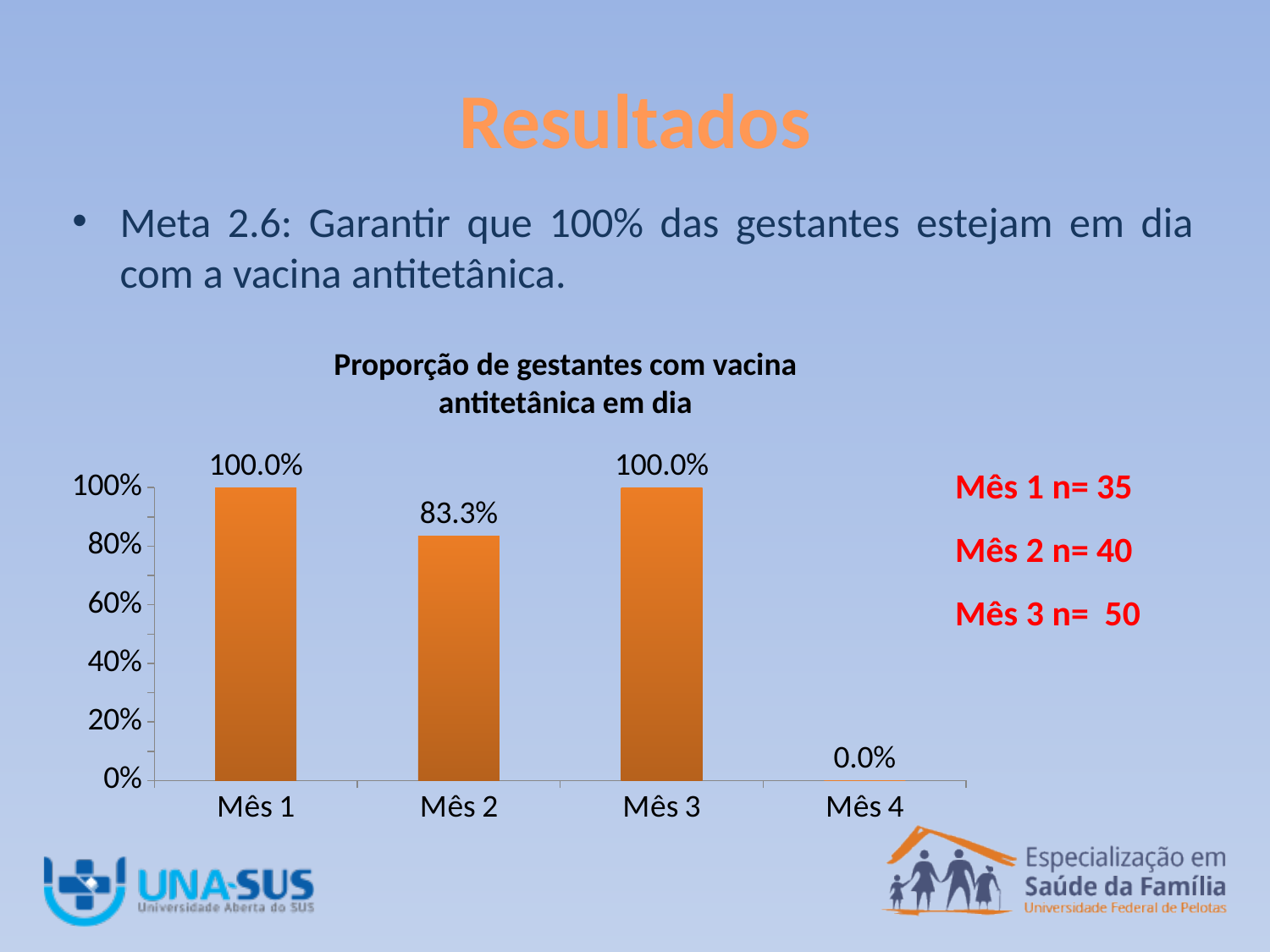
What is the value for Mês 4? 0.0% Is the value for Mês 2 greater or less than 80%? greater What is the difference between the values for Mês 3 and Mês 4? 100.0% What is the value for Mês 3? 100.0% What is the value for Mês 2? 83.3% What is the difference between the values for Mês 1 and Mês 2? 16.7% Which category has the lowest value? Mês 4 What is the value for Mês 1? 100.0% How many categories are shown on the x axis? 4 What is the title of the chart? Proporção de gestantes com vacina antitetânica em dia What kind of chart is shown on the slide? bar chart Which is larger, the value for Mês 2 or the value for Mês 3? Mês 3